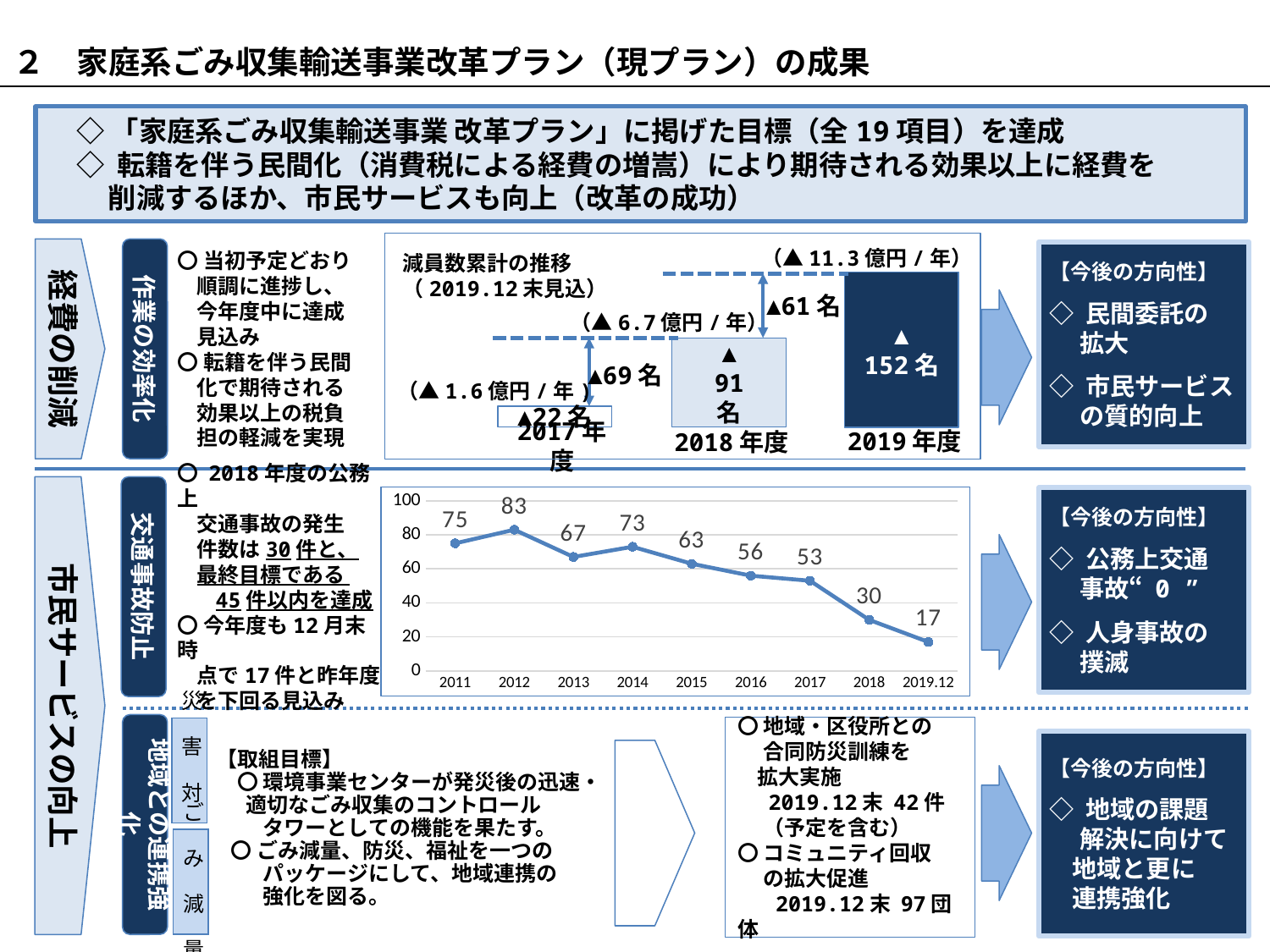
In the line chart in the middle of the slide, which point has the lowest value? 2019.12 In the line chart in the middle of the slide, do the values generally rise or fall from 2012 to 2019.12? fall In the 減員数累計の推移 diagram at the top of the slide, what is the value shown for 2019年度? 152名 In the line chart in the middle of the slide, what is the value for 2012? 83 In the line chart in the middle of the slide, how many data points are plotted? 9 In the line chart in the middle of the slide, which year has the highest value? 2012 What kind of chart is shown in the middle of the slide? line chart In the line chart in the middle of the slide, what is the difference between the values for 2011 and 2018? 45 In the line chart in the middle of the slide, what is the value for 2019.12? 17 In the line chart in the middle of the slide, what is the value for 2016? 56 In the line chart in the middle of the slide, which is larger, the value for 2013 or the value for 2014? 2014 In the 減員数累計の推移 diagram at the top of the slide, what is the value shown for 2017年度? 22名